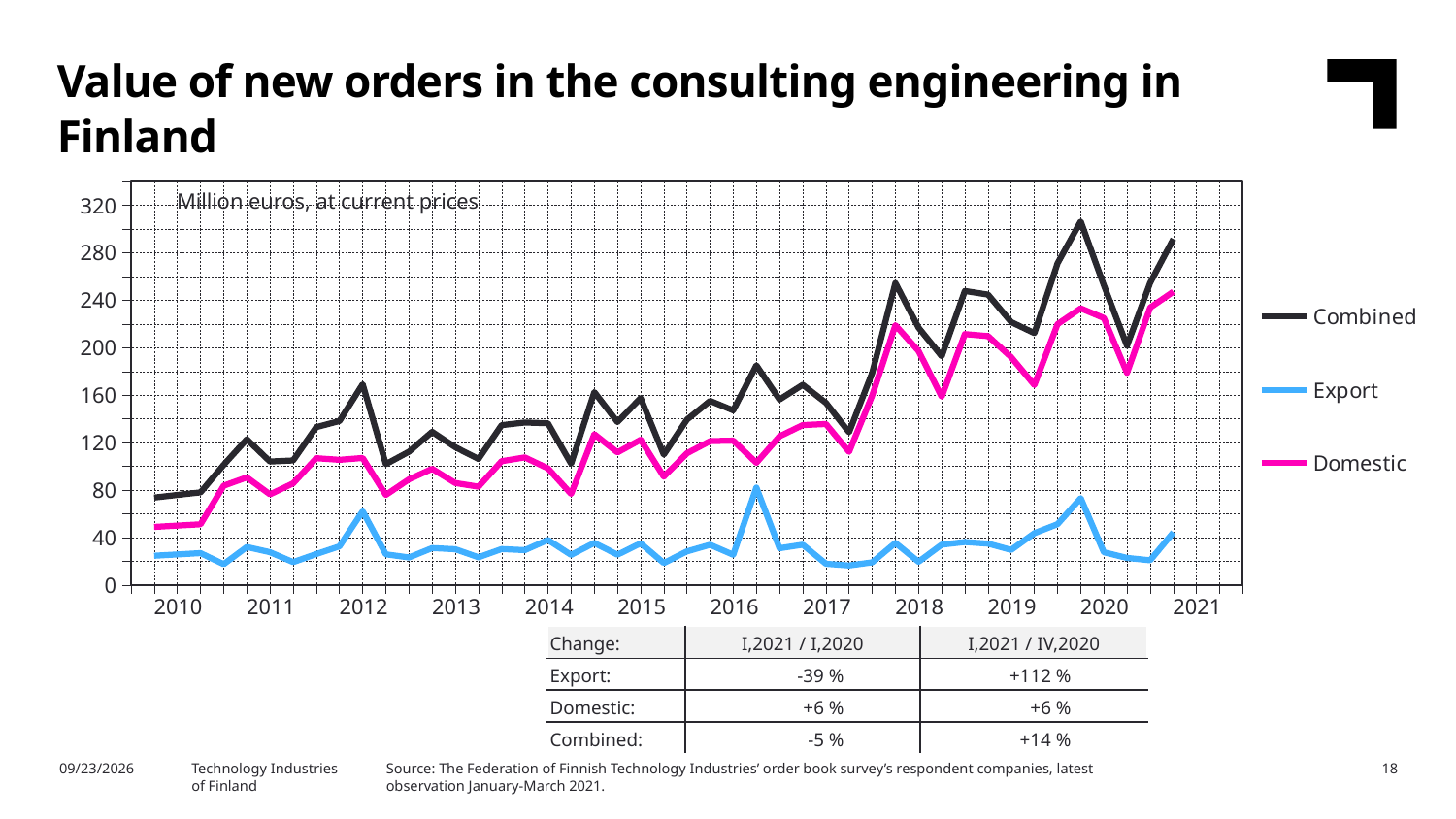
What unit label is printed inside the chart area? Million euros, at current prices Is the value of the Export series at the start of 2010 greater or less than 40? less Is the peak value of the Domestic series (around late 2019) greater or less than 200? greater Is the peak value of the Combined series (around late 2019) greater or less than 280? greater Does the Combined series overall rise or fall from 2010 to 2021? rise How many year labels are shown on the x axis? 12 How many series does the legend list? 3 Which series has the lowest values across the whole chart? Export Which series has the highest values across the whole chart? Combined What kind of chart is shown on the slide? line chart What are the three series named in the legend? Combined, Export, Domestic